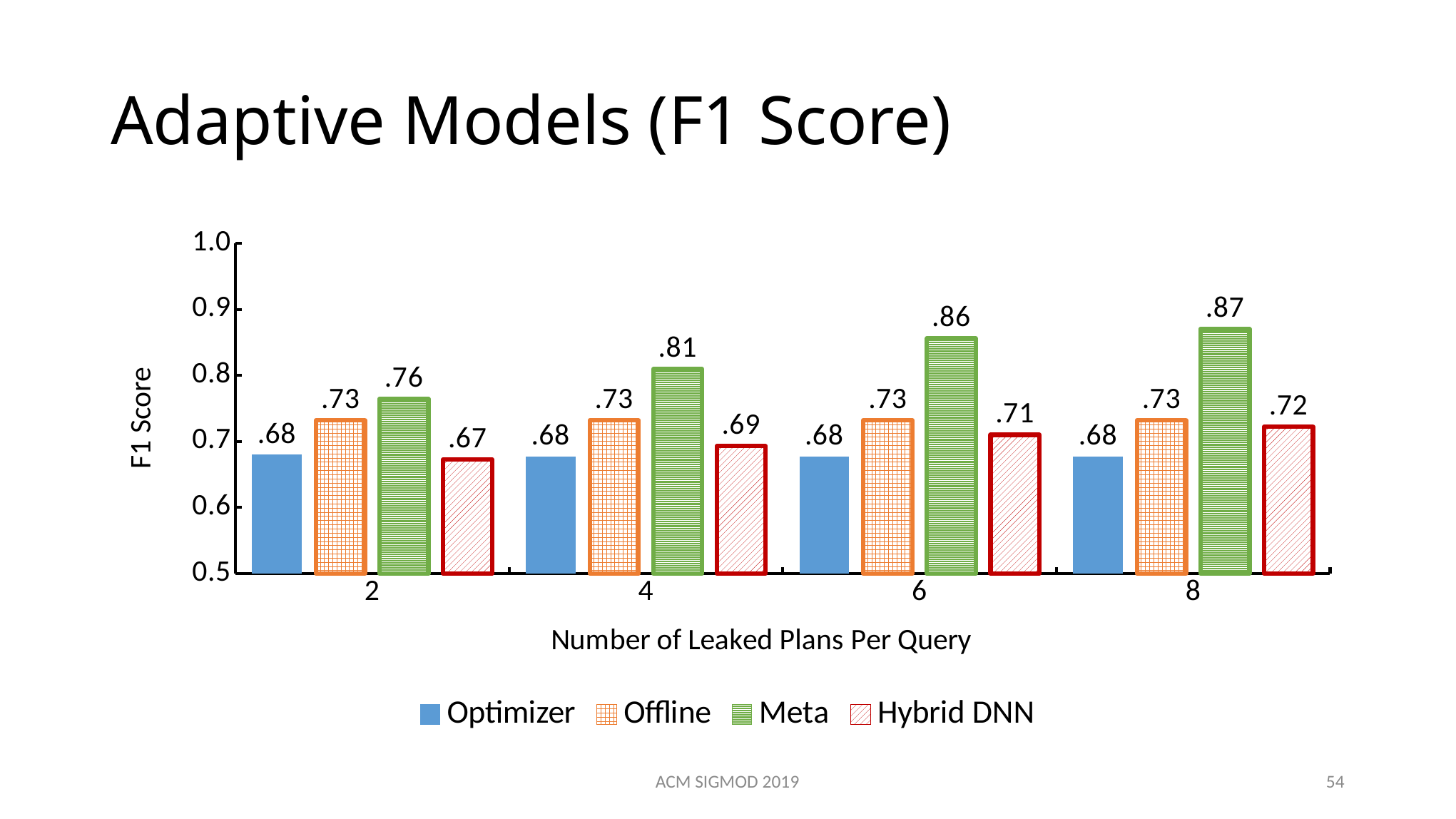
How many categories are shown on the x axis? 4 Which series has the lowest F1 score at 2 leaked plans per query? Hybrid DNN How many series does the legend list? 4 What kind of chart is shown on the slide? Bar chart Which series has the highest F1 score at 8 leaked plans per query? Meta What is the label of the y axis? F1 Score Does the Meta F1 score rise or fall as the number of leaked plans per query increases? Rises What is the difference between the Meta F1 score at 8 leaked plans and at 2 leaked plans? .11 At 4 leaked plans per query, which is larger: the Meta F1 score or the Offline F1 score? Meta What is the F1 score for Hybrid DNN at 2 leaked plans per query? .67 What is the F1 score for Offline at 8 leaked plans per query? .73 What is the F1 score for Meta at 6 leaked plans per query? .86